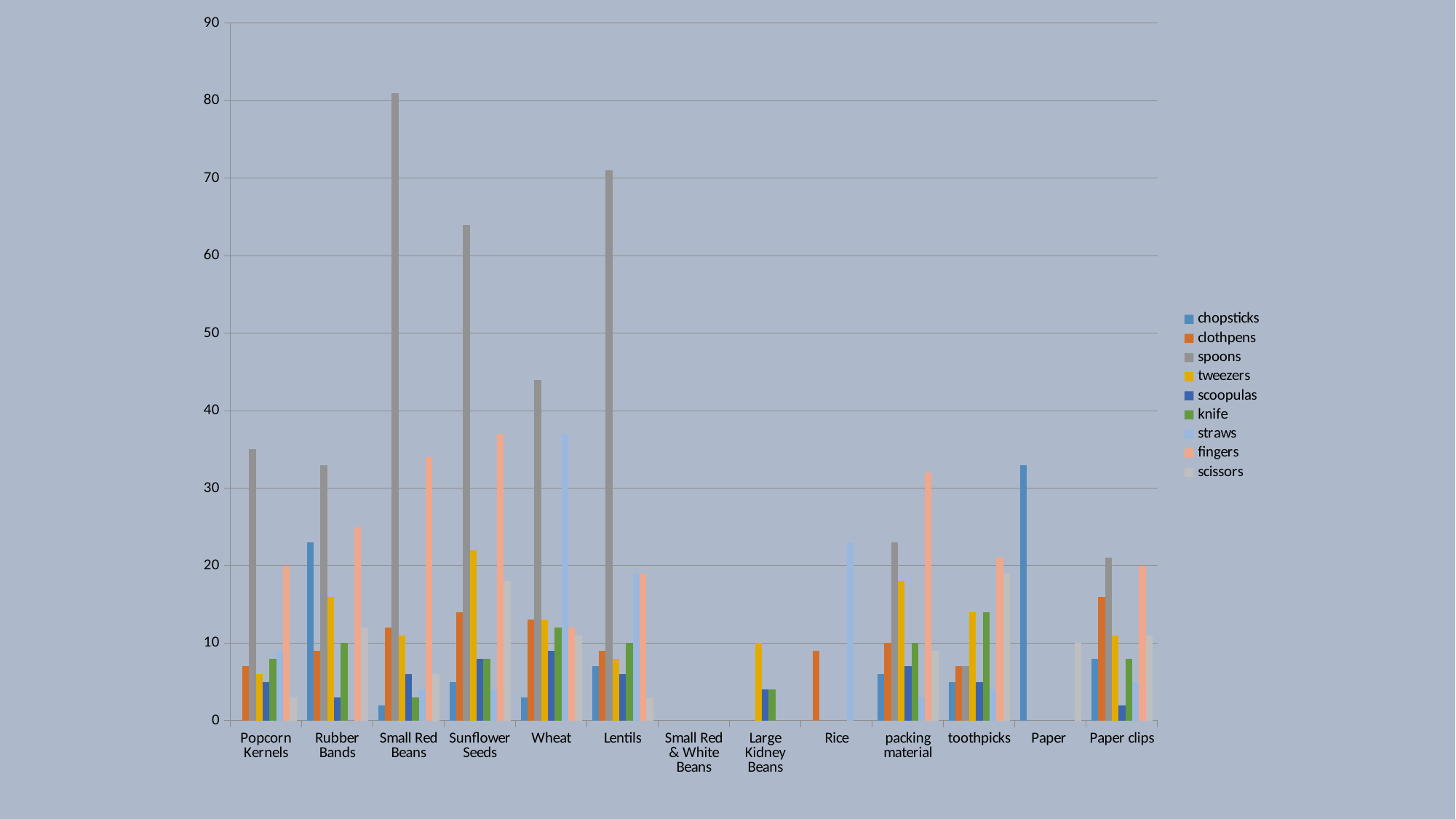
How many series does the legend list? 9 Which series is listed last in the legend? scissors Which category has the highest value for spoons? Small Red Beans Is the value for spoons for Lentils greater or less than 60? greater Which category has the highest value for chopsticks? Paper Is the value for straws for Rice greater or less than 20? greater Is the value for spoons for Wheat greater or less than 50? less How many categories are shown along the x axis? 13 What kind of chart is shown on the slide? bar chart Which is larger, the spoons value for Lentils or the spoons value for Wheat? Lentils